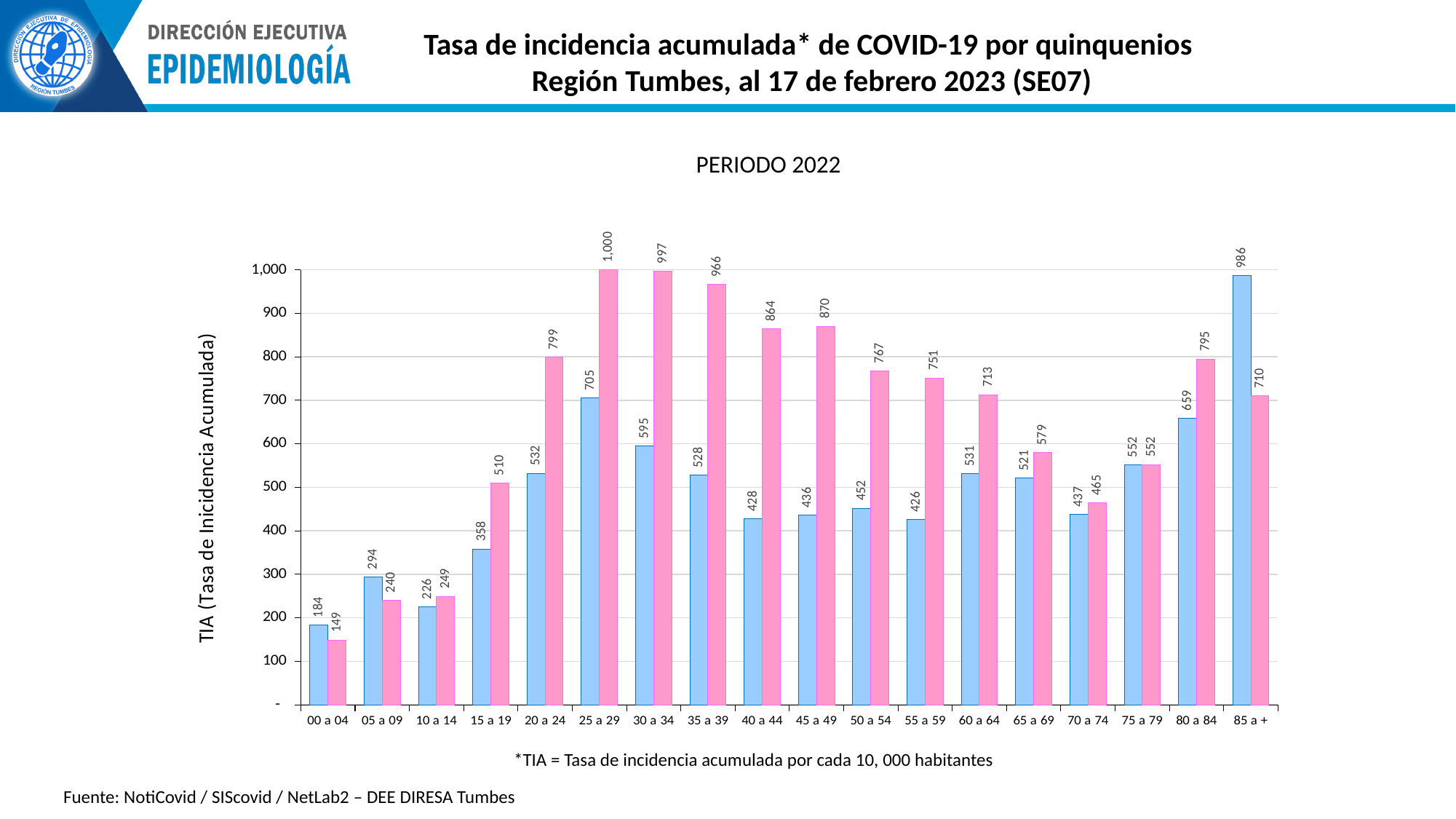
What is the title of the y axis? TIA (Tasa de Incidencia Acumulada) Which age group has the lowest blue bar? 00 a 04 What is the chart title shown above the plot area? PERIODO 2022 What kind of chart is shown on the slide? bar chart What is the difference between the pink and blue bars for the 20 a 24 age group? 267 How many age groups are shown on the x axis? 18 What is the value of the blue bar for the 25 a 29 age group? 705 Which age group has the highest pink bar? 25 a 29 Is the value of the pink bar for the 30 a 34 age group greater or less than 900? greater Which is larger for the 85 a + age group, the blue bar or the pink bar? the blue bar What is the value of the blue bar for the 85 a + age group? 986 What is the value of the pink bar for the 40 a 44 age group? 864